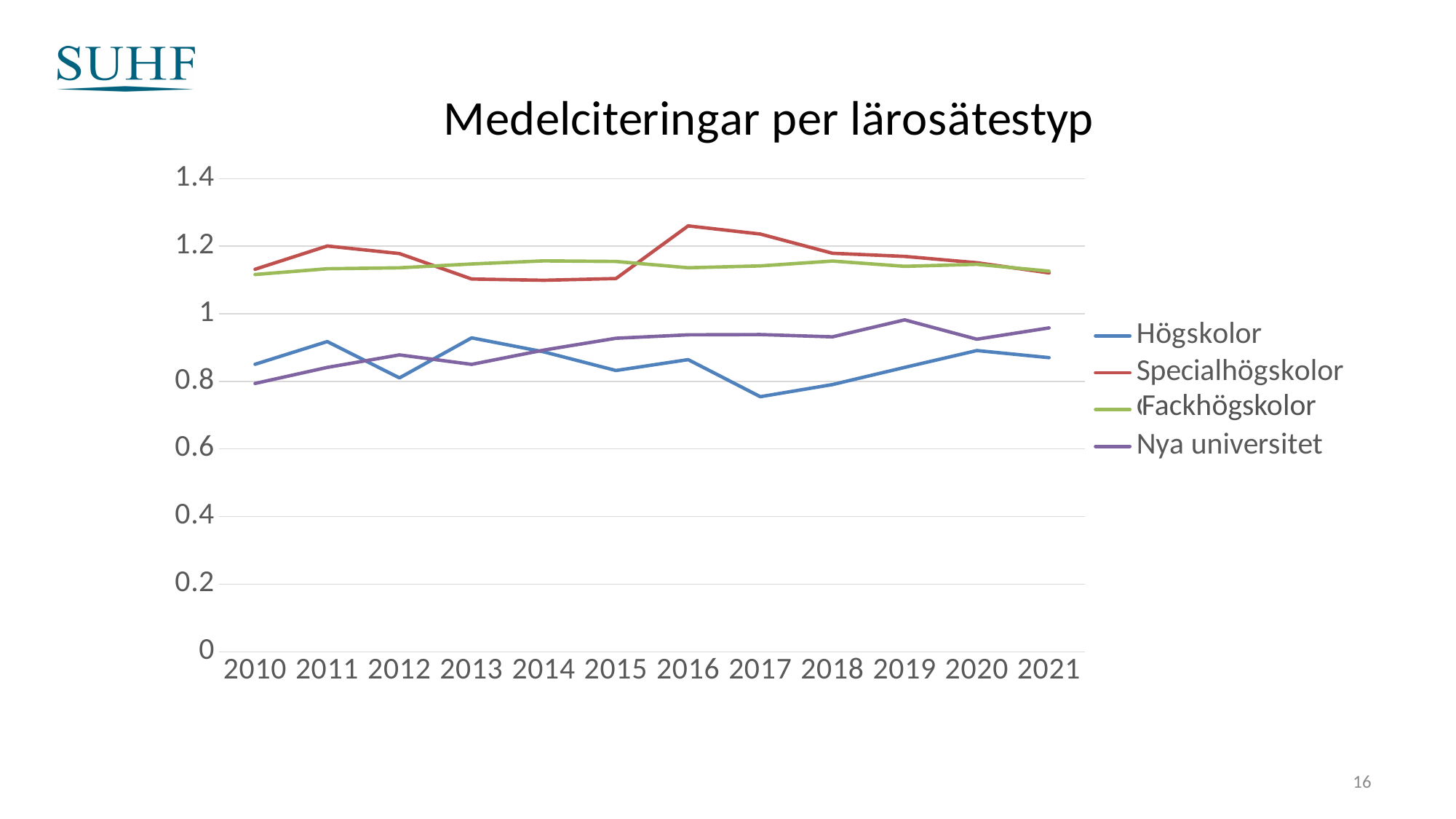
Which series has the highest value in 2016? Specialhögskolor Is the value for Specialhögskolor in 2016 greater or less than 1.2? greater What is the title of the chart? Medelciteringar per lärosätestyp Which series has the lowest value in 2017? Högskolor Does the Högskolor line rise or fall from 2017 to 2020? rise What colour is the line for Nya universitet? purple What kind of chart is shown on the slide? line chart Is the value for Fackhögskolor in 2015 greater or less than 1? greater How many series does the legend list? 4 How many years are shown on the x axis? 12 Is the value for Högskolor in 2017 greater or less than 0.8? less For Högskolor, which year has the larger value, 2011 or 2012? 2011